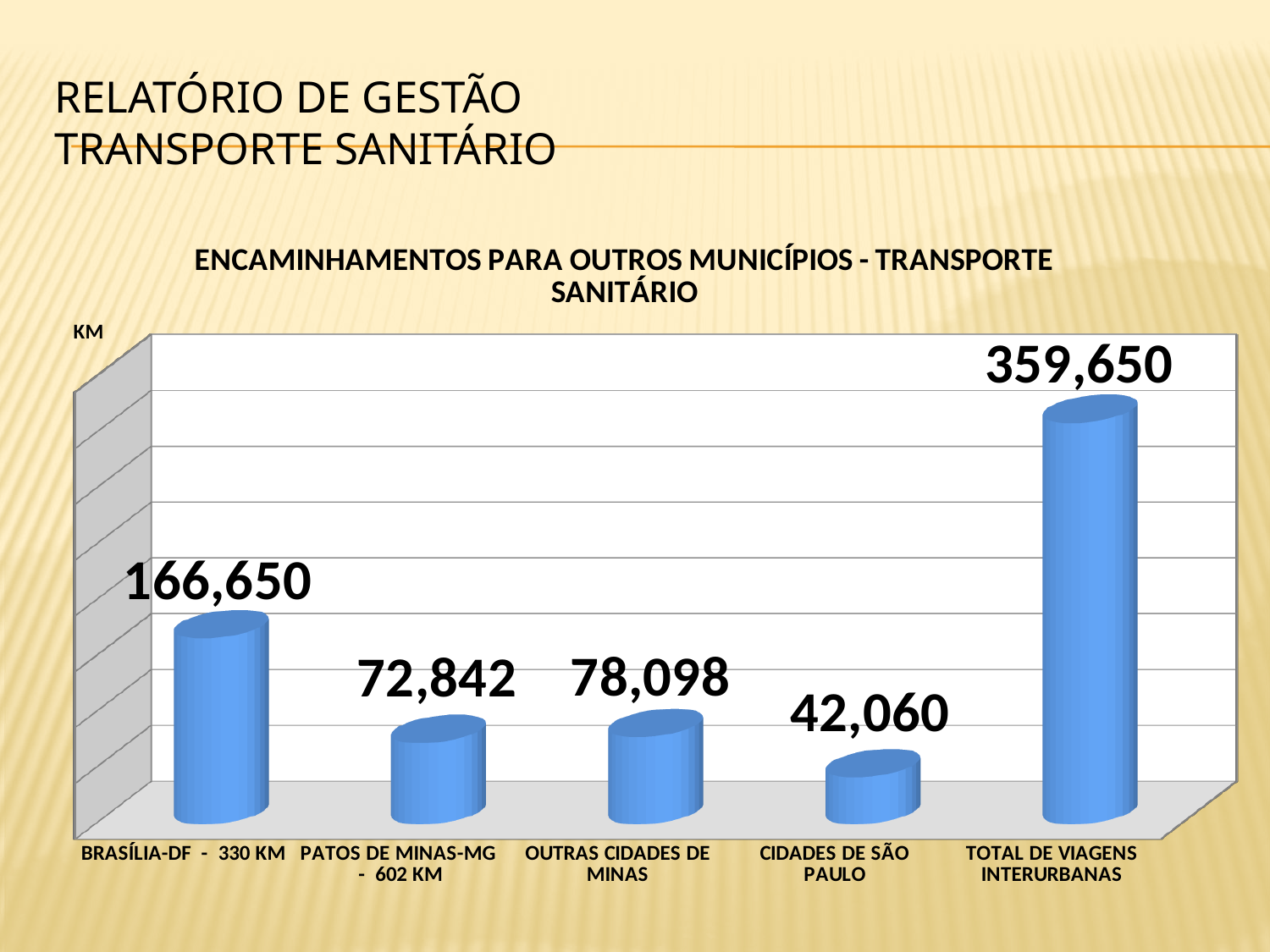
What is the difference between the values for OUTRAS CIDADES DE MINAS and PATOS DE MINAS-MG - 602 KM? 5,256 Which category has the lowest value? CIDADES DE SÃO PAULO What is the value for BRASÍLIA-DF - 330 KM? 166,650 What kind of chart is shown on the slide? Bar chart What is the value for PATOS DE MINAS-MG - 602 KM? 72,842 Which is larger, the value for OUTRAS CIDADES DE MINAS or the value for PATOS DE MINAS-MG - 602 KM? OUTRAS CIDADES DE MINAS What is the difference between the values for TOTAL DE VIAGENS INTERURBANAS and BRASÍLIA-DF - 330 KM? 193,000 What is the value for TOTAL DE VIAGENS INTERURBANAS? 359,650 What is the value for OUTRAS CIDADES DE MINAS? 78,098 What is the value for CIDADES DE SÃO PAULO? 42,060 How many categories are shown in the chart? 5 Which category has the highest value? TOTAL DE VIAGENS INTERURBANAS